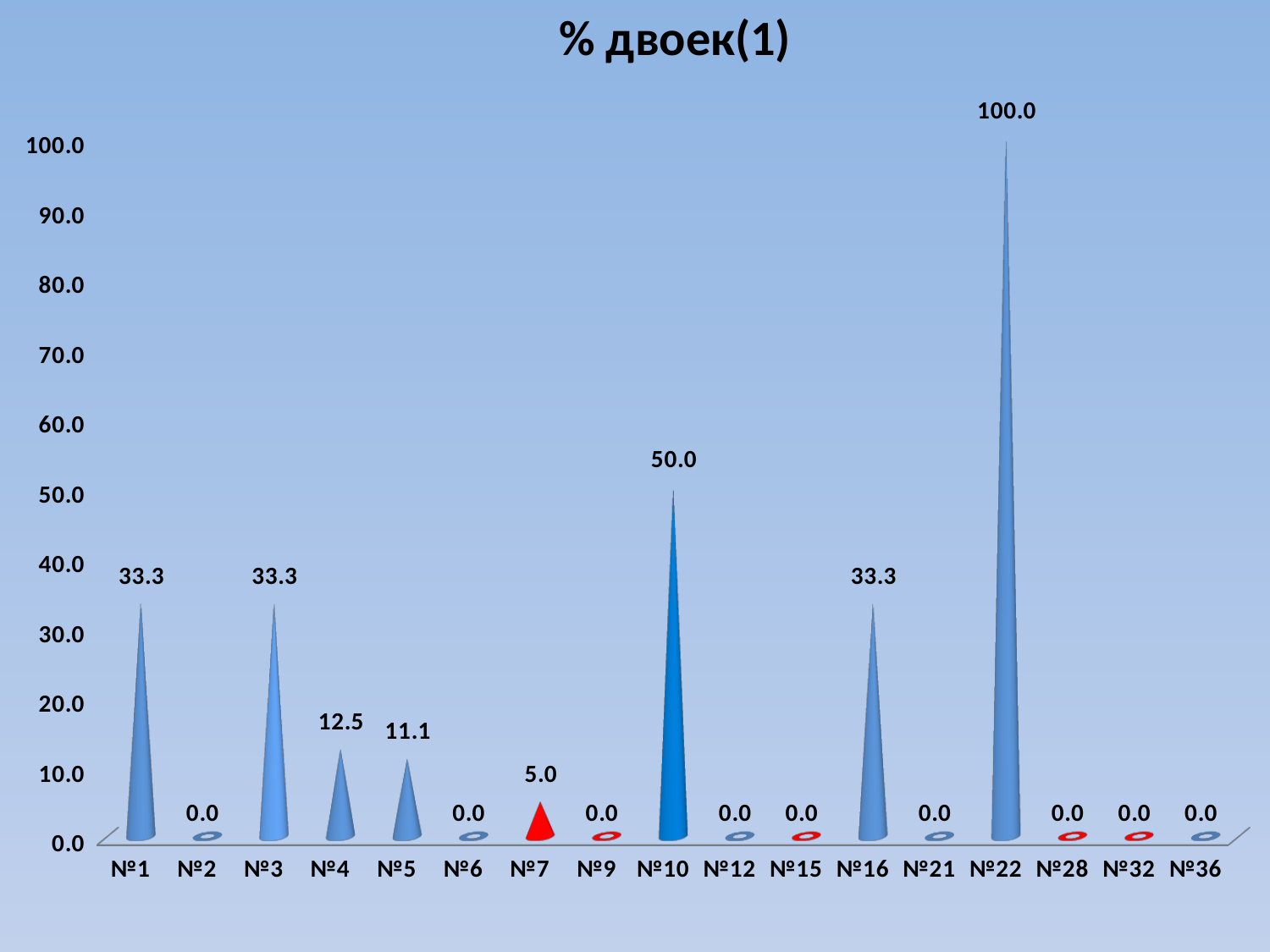
What is the difference between the values for №22 and №10? 50.0 What is the value for №7? 5.0 Which category has the highest value? №22 What is the value for №4? 12.5 What is the value for №22? 100.0 What is the difference between the values for №4 and №5? 1.4 What is the title of the chart? % двоек(1) What kind of chart is this? bar chart Which is larger, the value for №1 or the value for №4? №1 What is the value for №10? 50.0 How many categories are shown on the x axis? 17 What is the value for №5? 11.1